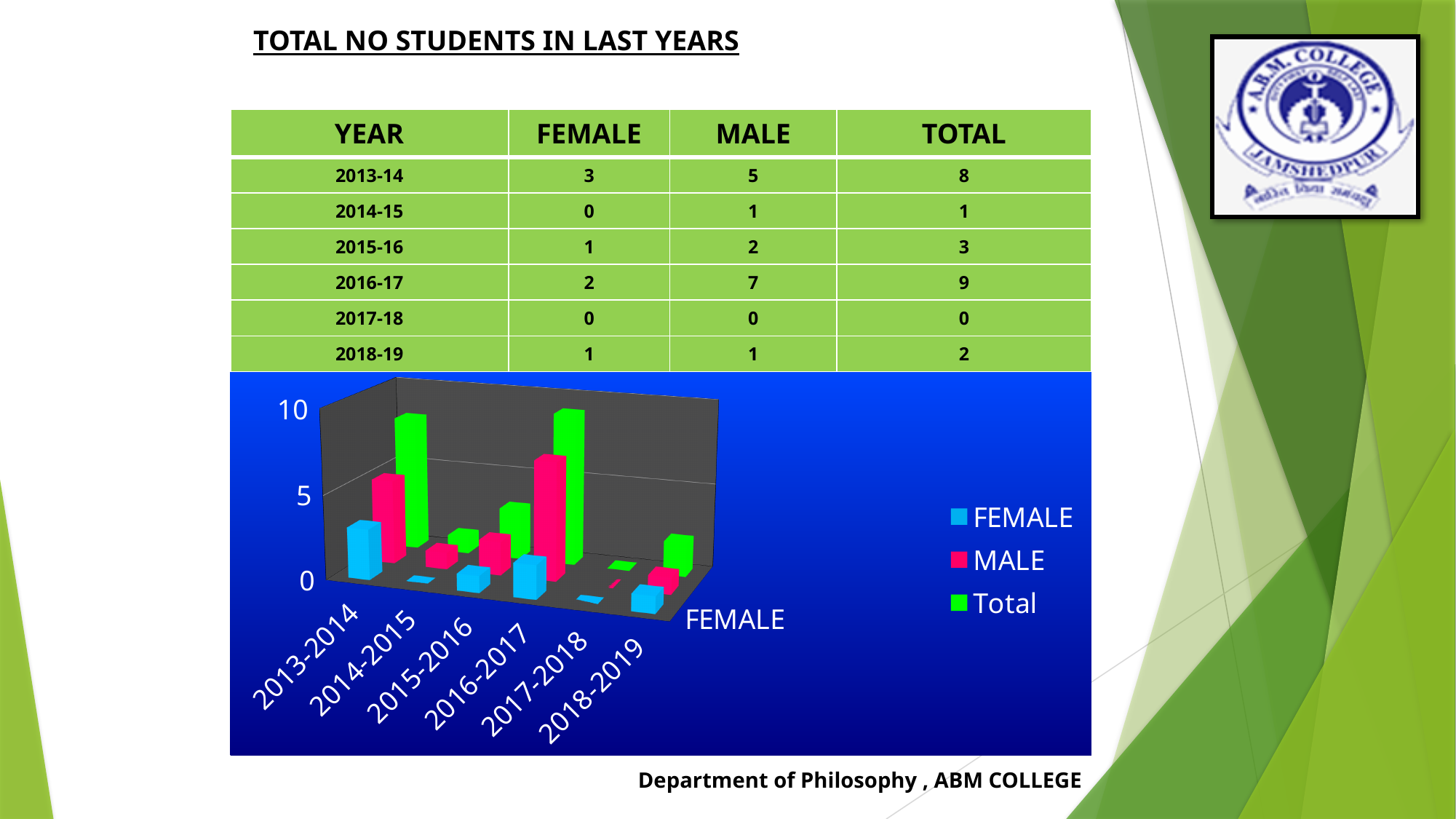
What is the highest value shown on the chart's vertical axis? 10 How many year categories are plotted along the x axis of the chart? 6 Which year has the lowest Total bar in the chart? 2017-2018 What is the MALE value for 2016-2017 shown on the slide? 7 What is the difference between the MALE value for 2016-2017 and the MALE value for 2013-2014? 2 Is the MALE value for 2015-2016 greater or less than 5? less Is the Total value for 2013-2014 greater or less than 5? greater How many series does the chart legend list? 3 What kind of chart is shown on the slide? bar chart Which is larger in the chart, the FEMALE bar for 2013-2014 or the FEMALE bar for 2018-2019? 2013-2014 Which year has the tallest MALE bar in the chart? 2016-2017 Which series is shown in green in the chart legend? Total